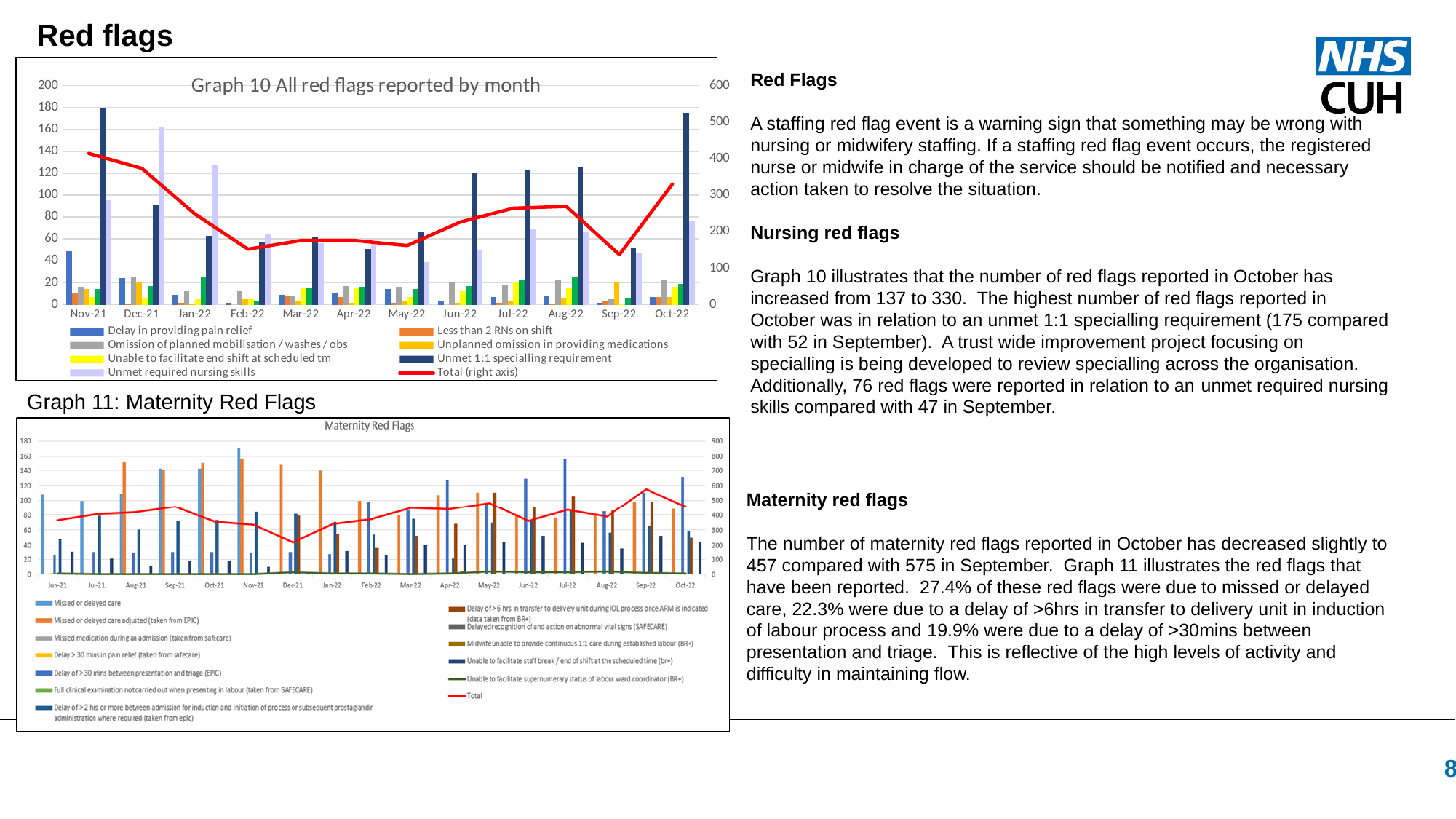
In Graph 10 All red flags reported by month, which month has the highest Unmet required nursing skills bar? Dec-21 What is the title of the top chart on the slide? Graph 10 All red flags reported by month In the Maternity Red Flags chart (Graph 11), how many months are shown on the x axis? 17 In Graph 10 All red flags reported by month, is the Total (right axis) value for Oct-22 greater or less than 300? greater In Graph 10 All red flags reported by month, is the Total (right axis) value for Sep-22 greater or less than 200? less In Graph 10 All red flags reported by month, is the Unmet 1:1 specialling requirement value for Oct-22 greater or less than 160? greater In Graph 10 All red flags reported by month, how many series does the legend list? 8 In Graph 10 All red flags reported by month, how many months are shown on the x axis? 12 In Graph 10 All red flags reported by month, does the Total line rise or fall from Nov-21 to Feb-22? Falls In Graph 10 All red flags reported by month, which is larger in Jun-22: Unmet 1:1 specialling requirement or Unmet required nursing skills? Unmet 1:1 specialling requirement What kind of chart is Graph 10 All red flags reported by month? Combined bar and line chart